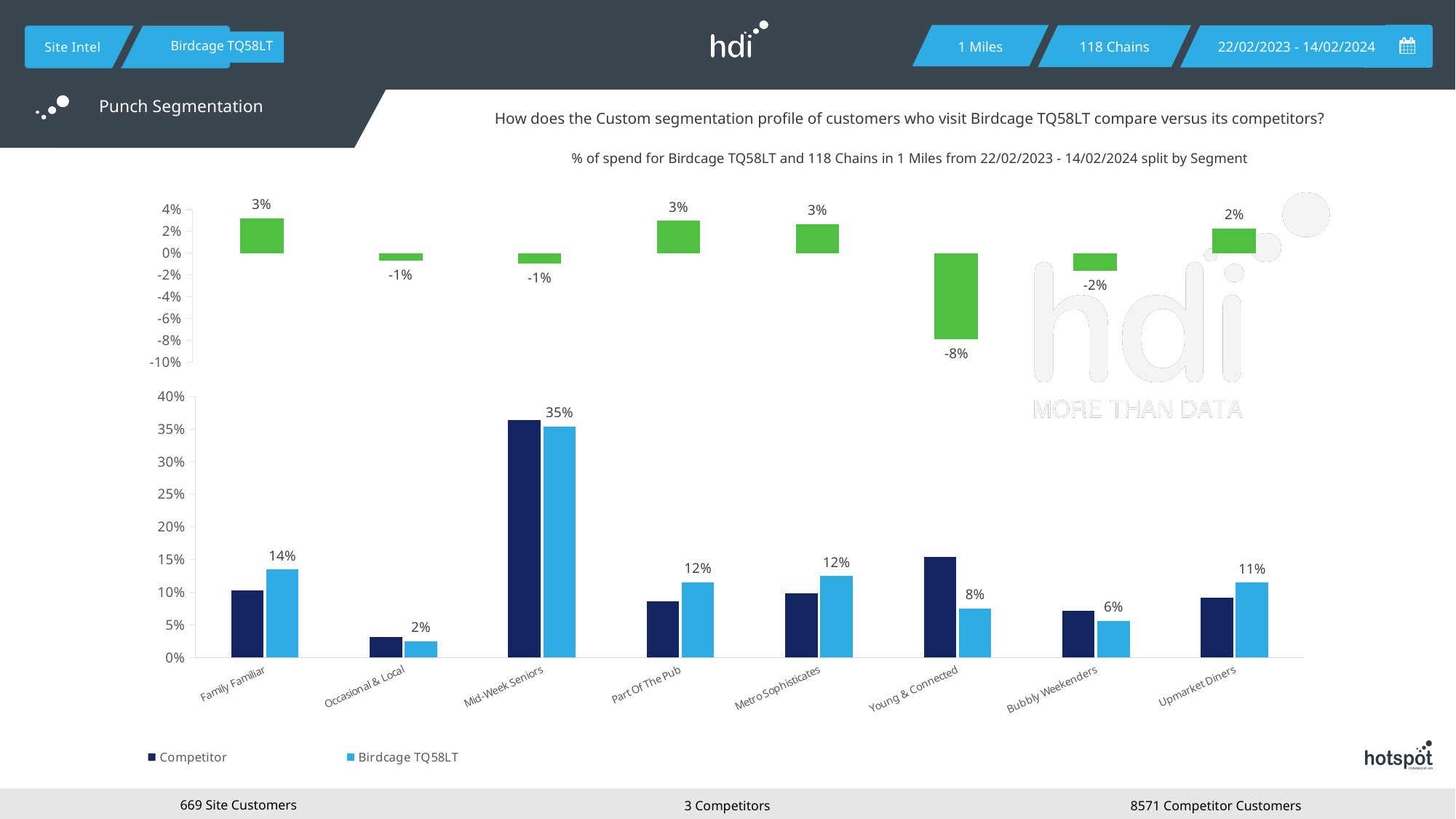
In the bottom grouped bar chart, what is the difference between the Birdcage TQ58LT values for Mid-Week Seniors and Family Familiar? 21% In the bottom grouped bar chart, what is the value for Birdcage TQ58LT in the Mid-Week Seniors segment? 35% In the bottom grouped bar chart, what is the value for Birdcage TQ58LT in the Family Familiar segment? 14% In the bottom grouped bar chart, is the Competitor value for Young & Connected greater or less than 10%? greater In the bottom grouped bar chart, which is larger for Young & Connected: the Competitor bar or the Birdcage TQ58LT bar? Competitor How many series does the legend of the bottom grouped bar chart list? 2 What kind of chart is the bottom chart on the slide? Bar chart In the top green bar chart, which segment has the lowest value? Young & Connected In the bottom grouped bar chart, which segment has the highest Birdcage TQ58LT value? Mid-Week Seniors In the bottom grouped bar chart, which segment has the lowest Birdcage TQ58LT value? Occasional & Local How many segments are shown on the x axis of the bottom grouped bar chart? 8 In the top green bar chart, what is the value for Young & Connected? -8%